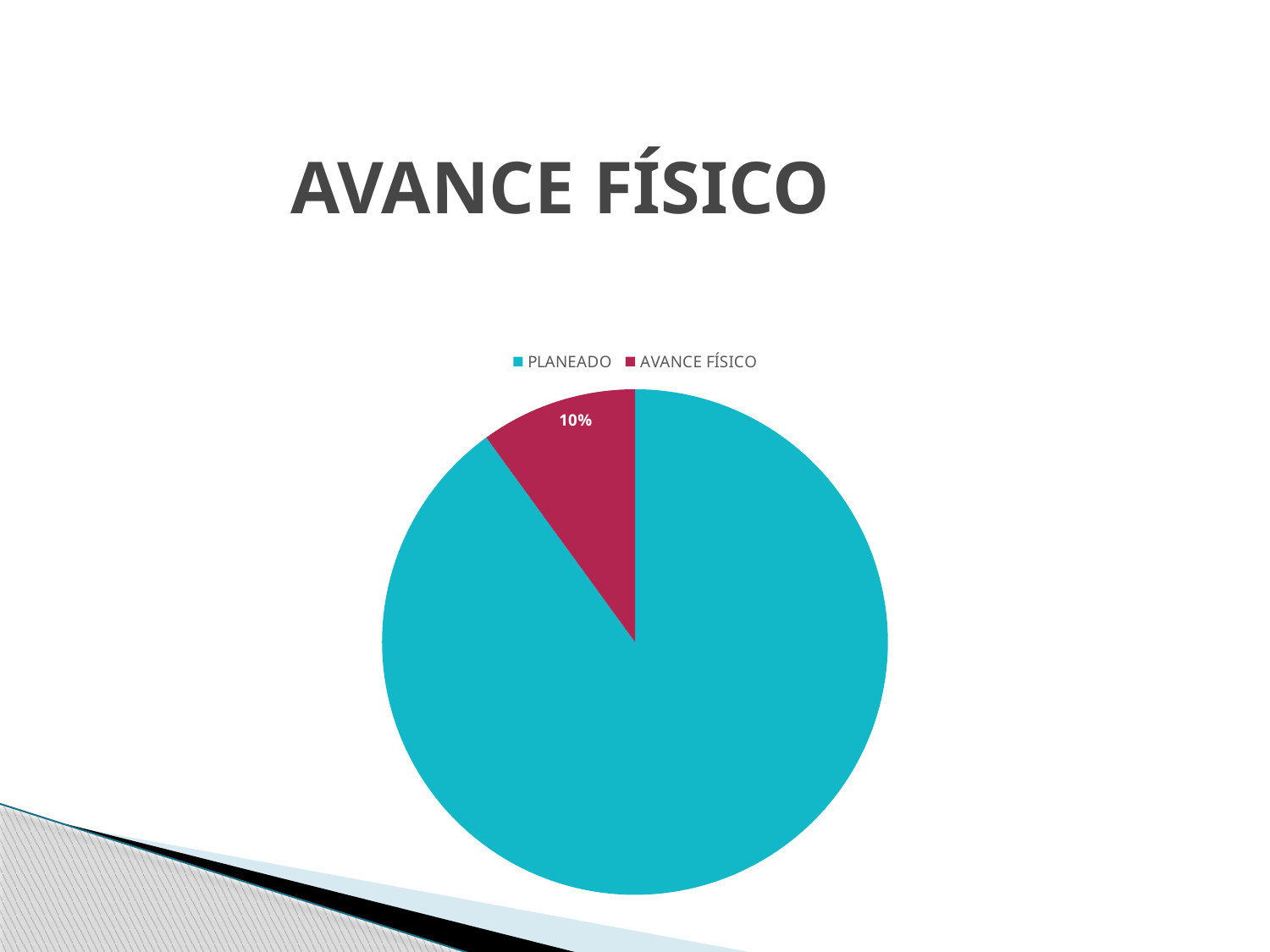
Which slice is larger in the pie chart, PLANEADO or AVANCE FÍSICO? PLANEADO How many entries does the legend of the pie chart list? 2 What is the title shown above the pie chart on the slide? AVANCE FÍSICO Which slice of the pie chart is the smallest? AVANCE FÍSICO What kind of chart is shown on the slide? pie chart How many slices does the pie chart have? 2 Does the PLANEADO slice take up more or less than half of the pie? more Which slice of the pie chart is the largest? PLANEADO What share of the pie does the AVANCE FÍSICO slice represent? 10% What percentage is labelled on the AVANCE FÍSICO slice of the pie chart? 10% Which legend entry of the pie chart is shown in red? AVANCE FÍSICO